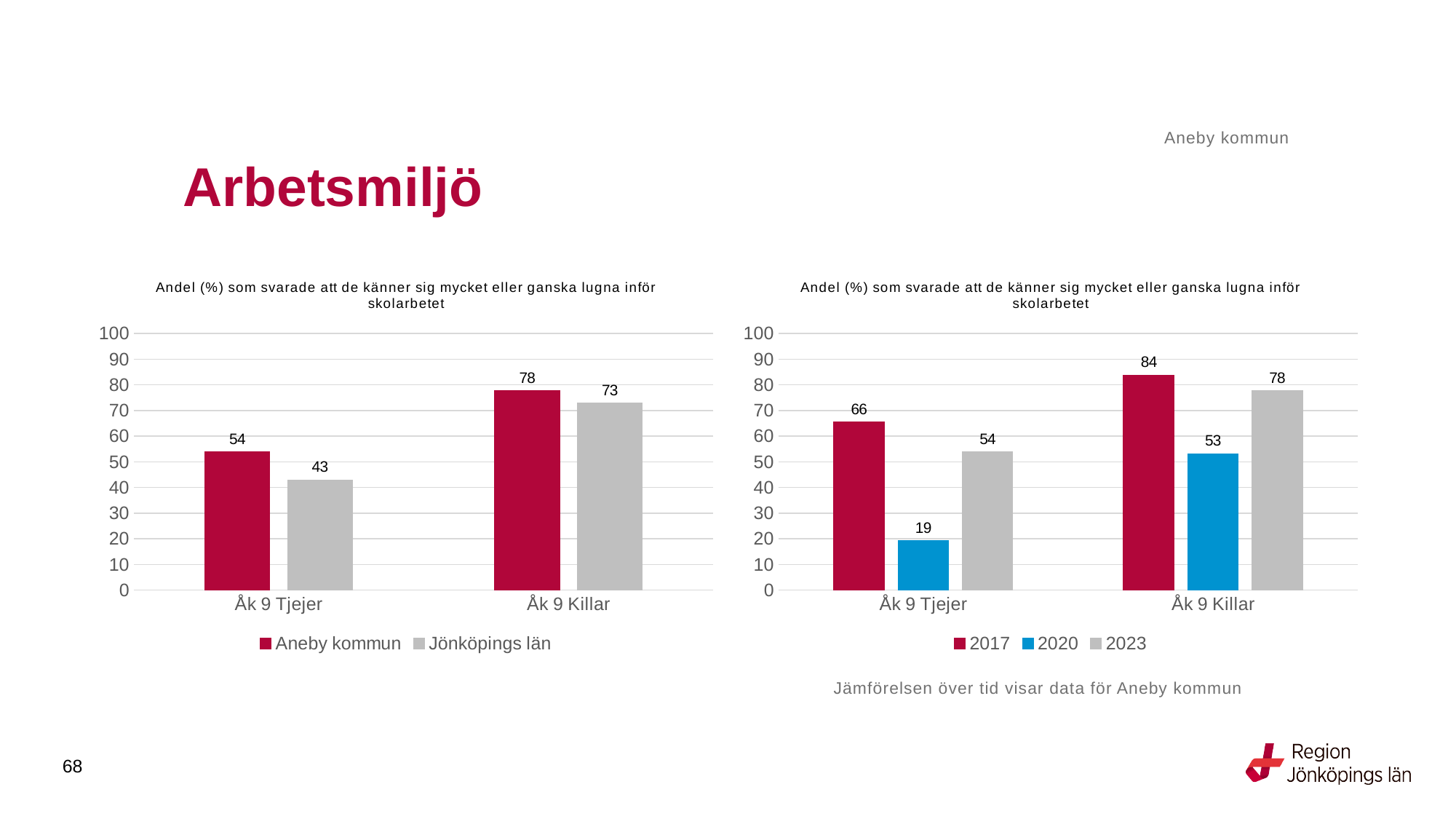
In the right chart, what is the value for 2017 for Åk 9 Killar? 84 In the right chart, what is the value for 2020 for Åk 9 Tjejer? 19 In the left chart, which is larger for Åk 9 Killar: Aneby kommun or Jönköpings län? Aneby kommun In the left chart, what is the difference between Aneby kommun and Jönköpings län for Åk 9 Tjejer? 11 In the right chart, how many series does the legend list? 3 In the left chart, what is the value for Aneby kommun for Åk 9 Tjejer? 54 In the left chart, how many series does the legend list? 2 In the right chart, which category has the highest value for 2023? Åk 9 Killar In the right chart, which year has the lowest value for Åk 9 Tjejer? 2020 In the left chart, what is the value for Jönköpings län for Åk 9 Killar? 73 What kind of chart is the right chart? Bar chart In the right chart, what is the difference between 2023 and 2020 for Åk 9 Killar? 25